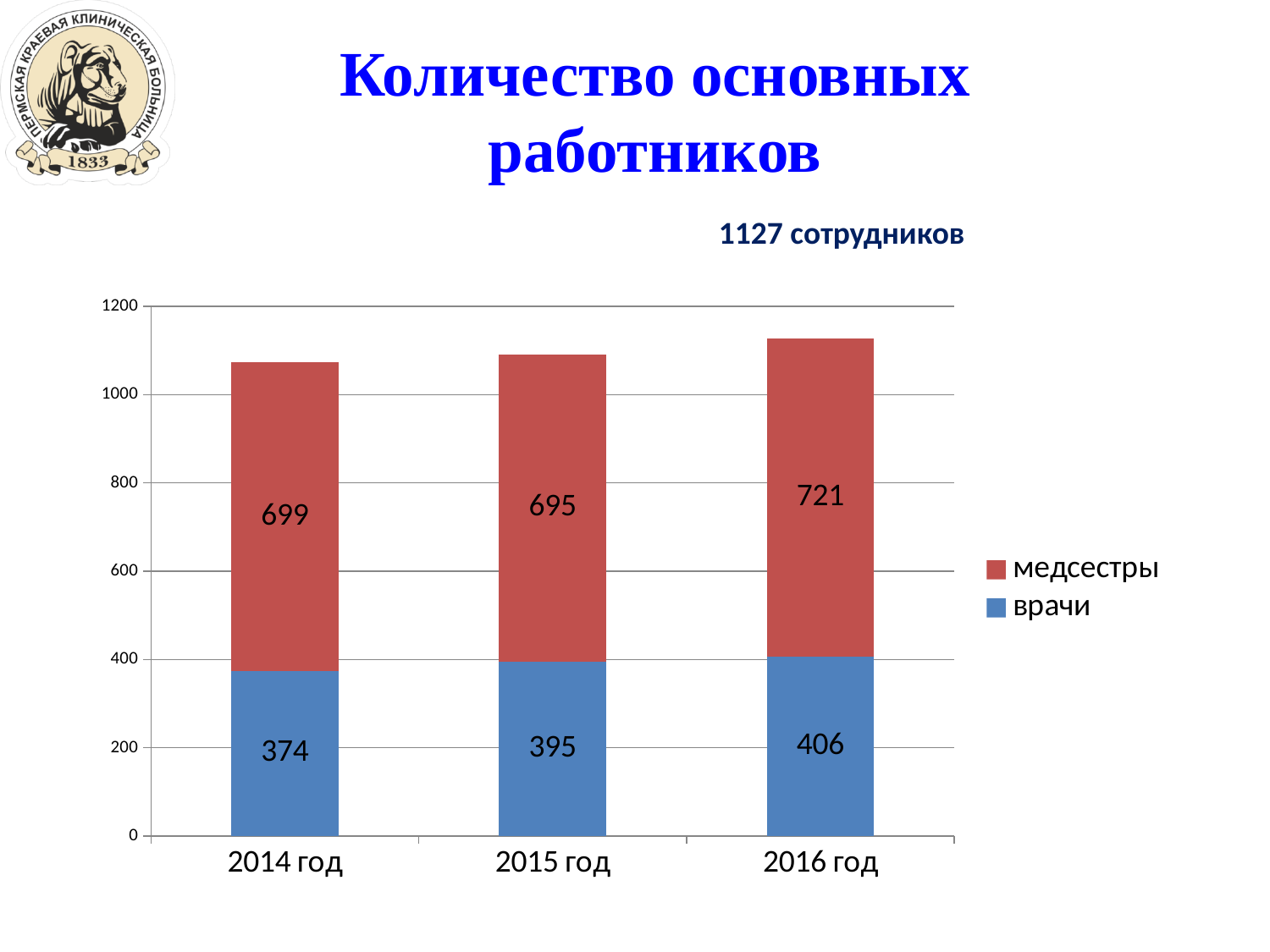
How many years are shown on the x axis? 3 In which year is the value for медсестры lowest? 2015 год What is the total of the stacked bar for 2014 год? 1073 What is the value for медсестры in 2015 год? 695 What is the difference between the врачи values for 2016 год and 2014 год? 32 How many series does the legend list? 2 In which year is the value for врачи highest? 2016 год What kind of chart is shown on the slide? stacked bar chart What is the value for врачи in 2014 год? 374 What is the value for медсестры in 2016 год? 721 Which is larger: медсестры in 2014 год or медсестры in 2015 год? медсестры in 2014 год What is the total of the stacked bar for 2016 год? 1127